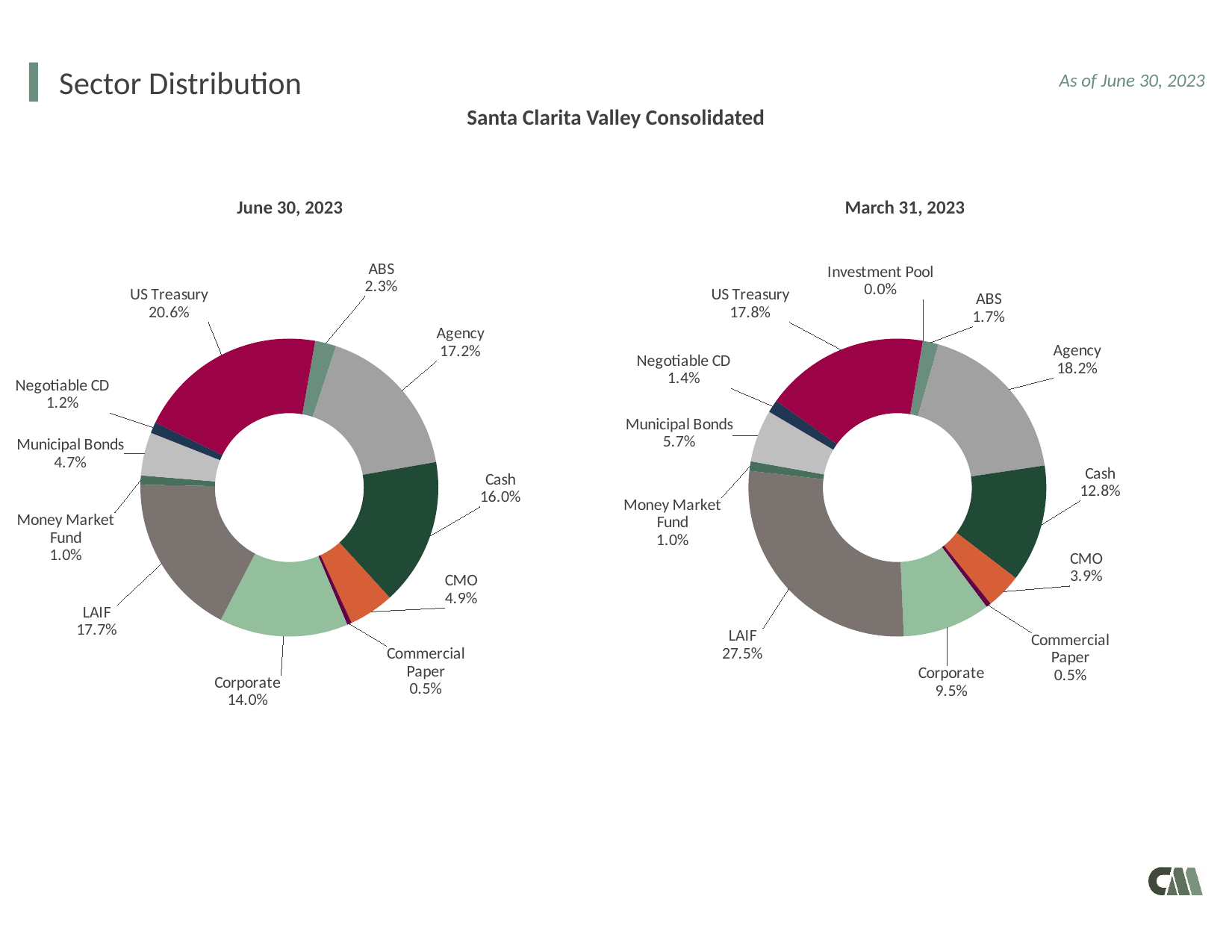
How many sectors are shown in the June 30, 2023 chart? 11 What type of chart is used for the June 30, 2023 sector distribution? Doughnut (pie) chart In the March 31, 2023 chart, what is the difference between the Agency share and the Cash share? 5.4% In the June 30, 2023 chart, which is larger, LAIF or Corporate? LAIF In the March 31, 2023 chart, which sector has the smallest share? Investment Pool In the March 31, 2023 chart, which is larger, Municipal Bonds or CMO? Municipal Bonds In the June 30, 2023 chart, what is the difference between the Agency share and the Cash share? 1.2% How many sectors are shown in the March 31, 2023 chart? 12 In the March 31, 2023 chart, what share does LAIF hold? 27.5% In the June 30, 2023 chart, which sector has the largest share? US Treasury In the June 30, 2023 chart, which sector has the smallest share? Commercial Paper In the June 30, 2023 chart, what share does US Treasury hold? 20.6%